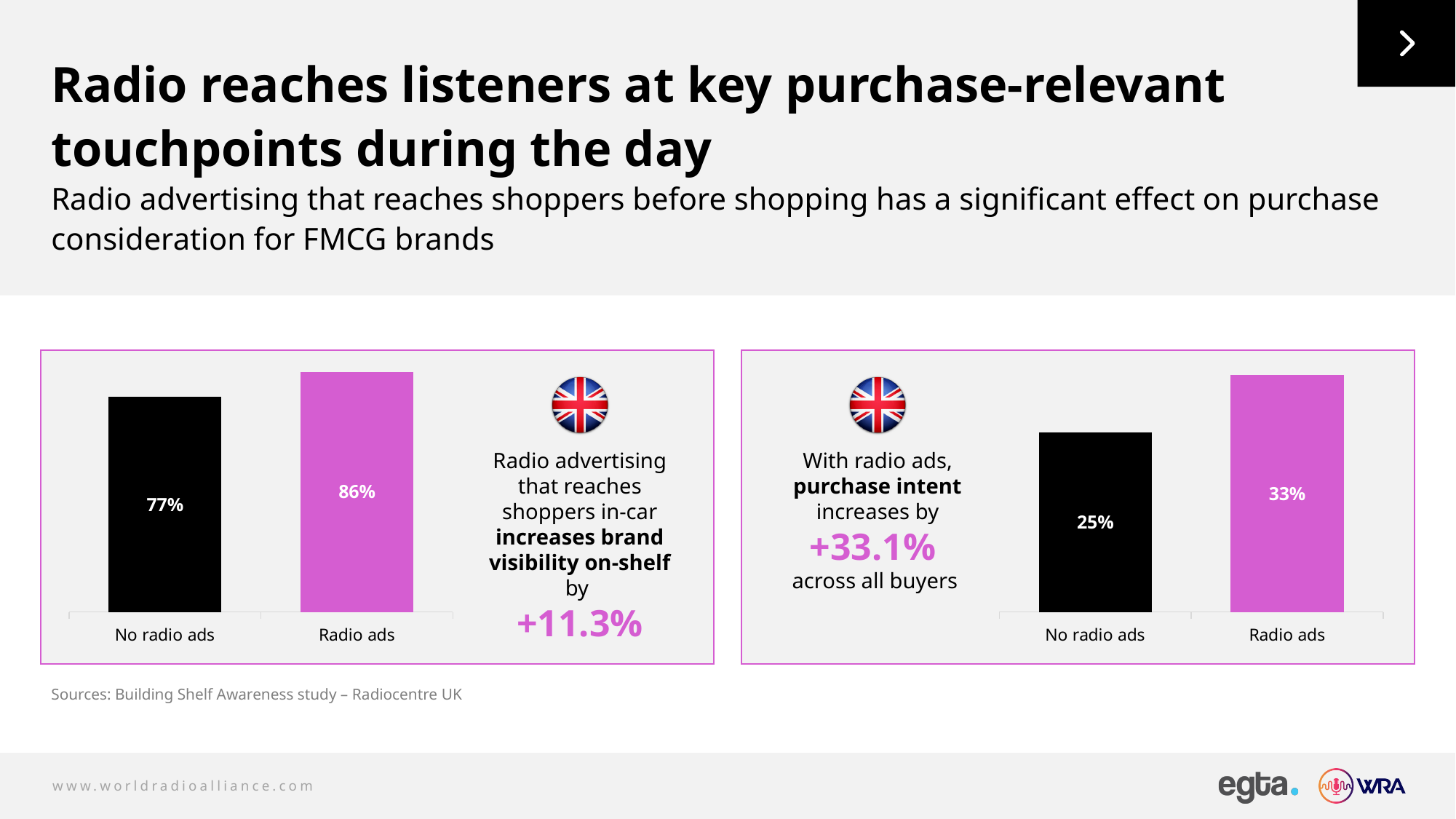
In the left chart (brand visibility on-shelf), what is the value for Radio ads? 86% In the right chart (purchase intent), what is the difference between Radio ads and No radio ads? 8 percentage points In the left chart (brand visibility on-shelf), what is the difference between Radio ads and No radio ads? 9 percentage points In the right chart (purchase intent), is the value for Radio ads larger or smaller than the value for No radio ads? larger How many categories does the left chart (brand visibility on-shelf) show? 2 What kind of chart is the right chart (purchase intent)? bar chart In the right chart (purchase intent), which category has the lower value? No radio ads In the left chart (brand visibility on-shelf), what is the value for No radio ads? 77% In the right chart (purchase intent), what is the value for No radio ads? 25% In the left chart (brand visibility on-shelf), what colour is the Radio ads bar? magenta/pink In the left chart (brand visibility on-shelf), which category has the higher value? Radio ads In the right chart (purchase intent), what is the value for Radio ads? 33%